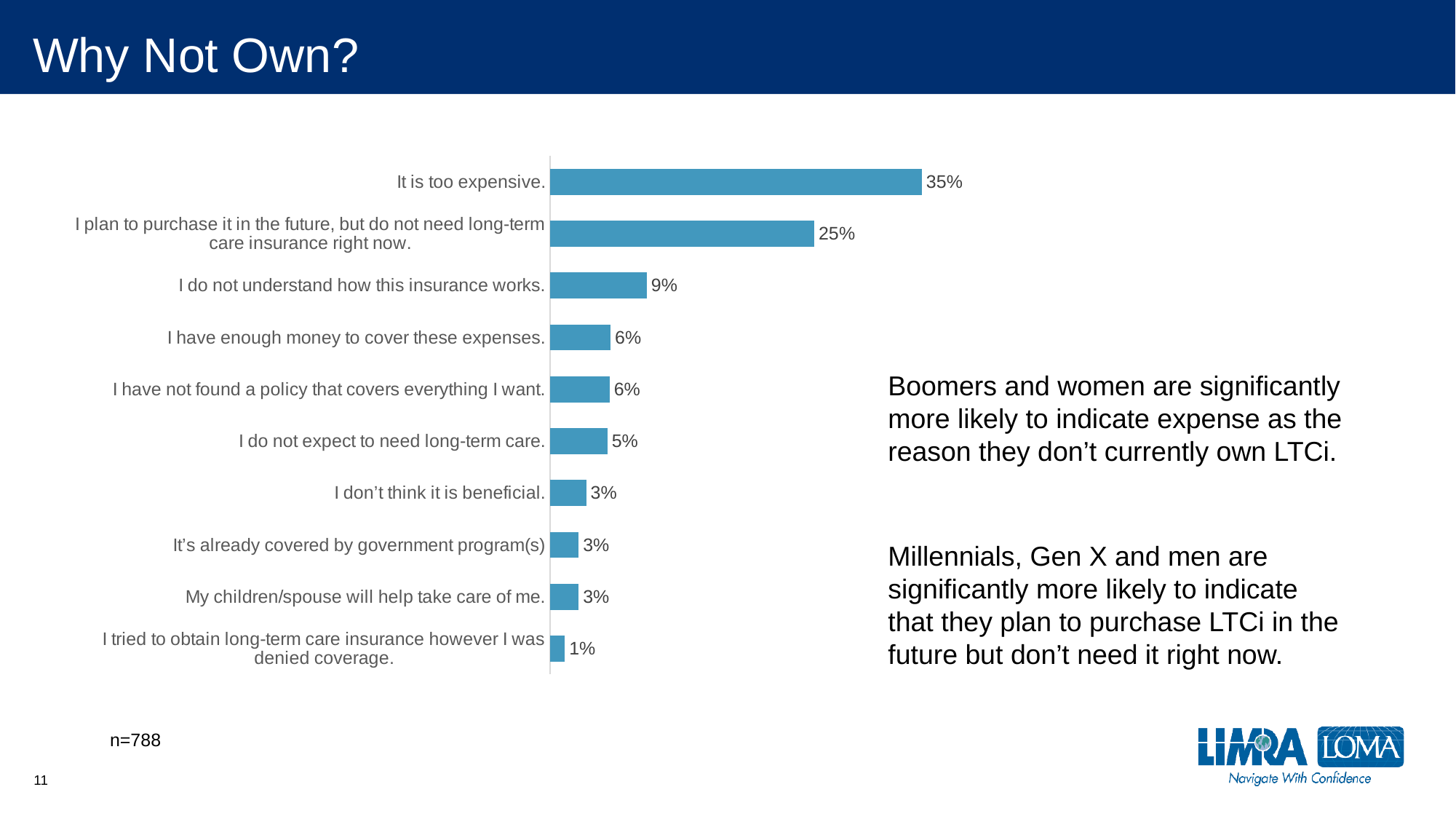
What percentage of respondents said "It is too expensive" as the reason for not owning long-term care insurance? 35% What percentage of respondents said "I do not understand how this insurance works"? 9% How many reasons (categories) are shown in the chart? 10 What percentage of respondents said "I plan to purchase it in the future, but do not need long-term care insurance right now"? 25% What percentage of respondents said "I tried to obtain long-term care insurance however I was denied coverage"? 1% Which has a higher percentage: "I do not understand how this insurance works" or "I do not expect to need long-term care"? I do not understand how this insurance works. What is the difference in percentage points between "It is too expensive" and "I plan to purchase it in the future, but do not need long-term care insurance right now"? 10 percentage points What is the sample size (n) noted on the slide? n=788 What is the title of the slide containing the chart? Why Not Own? What type of chart is shown on the slide? Bar chart Which reason for not owning long-term care insurance has the highest percentage? It is too expensive. Which reason for not owning long-term care insurance has the lowest percentage? I tried to obtain long-term care insurance however I was denied coverage.